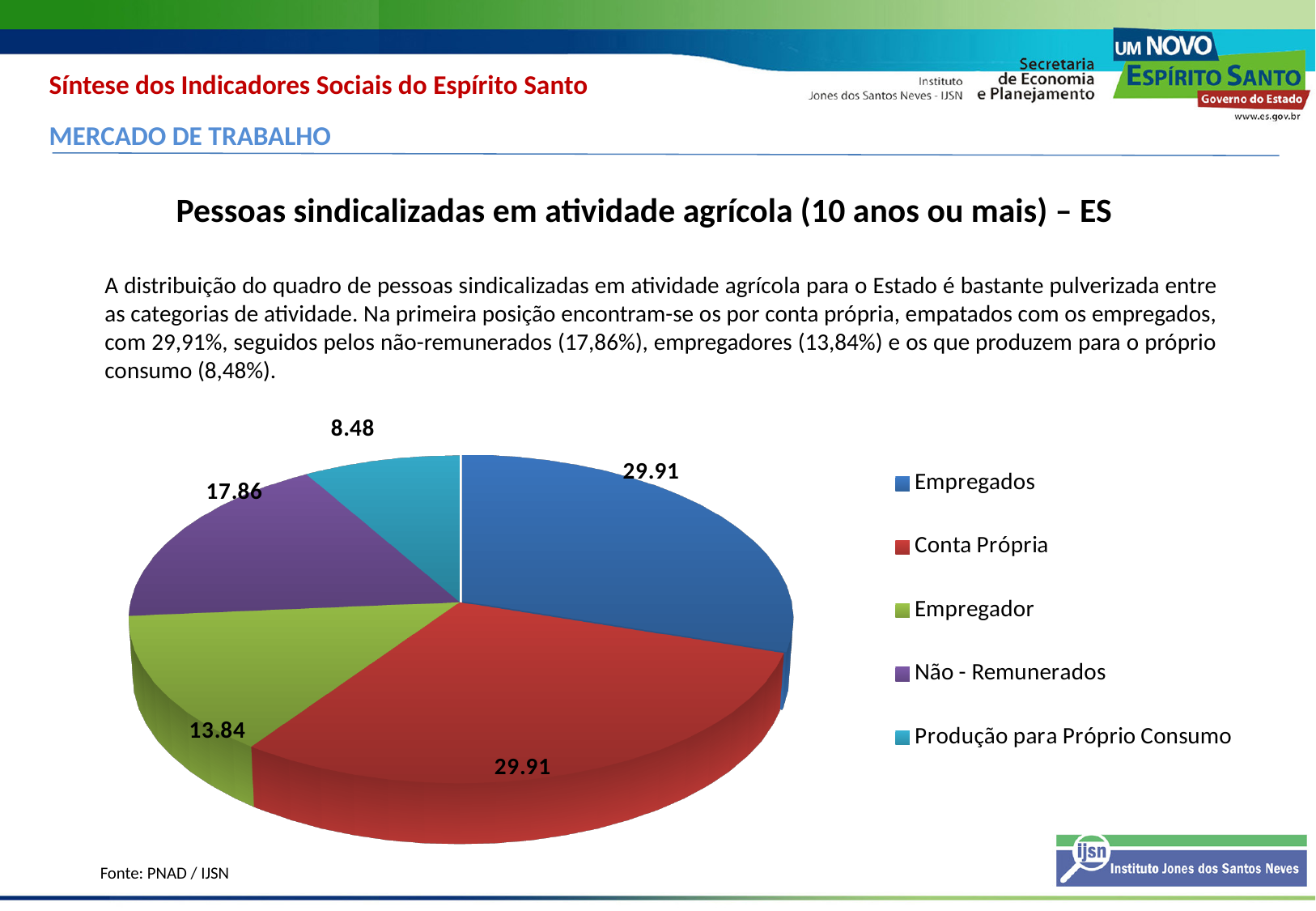
What is the value for Produção para Próprio Consumo in the pie chart? 8.48 What is the difference between the values for Empregados and Produção para Próprio Consumo? 21.43 How many categories does the pie chart show? 5 Which colour represents Conta Própria in the pie chart? red What type of chart is shown on the slide? pie chart Which is larger, the slice for Empregador or the slice for Não - Remunerados? Não - Remunerados What is the title of the chart on the slide? Pessoas sindicalizadas em atividade agrícola (10 anos ou mais) – ES What is the difference between the values for Não - Remunerados and Empregador? 4.02 What is the value for Empregador in the pie chart? 13.84 Which category has the smallest slice in the pie chart? Produção para Próprio Consumo What is the value for Conta Própria in the pie chart? 29.91 What is the value for Não - Remunerados in the pie chart? 17.86